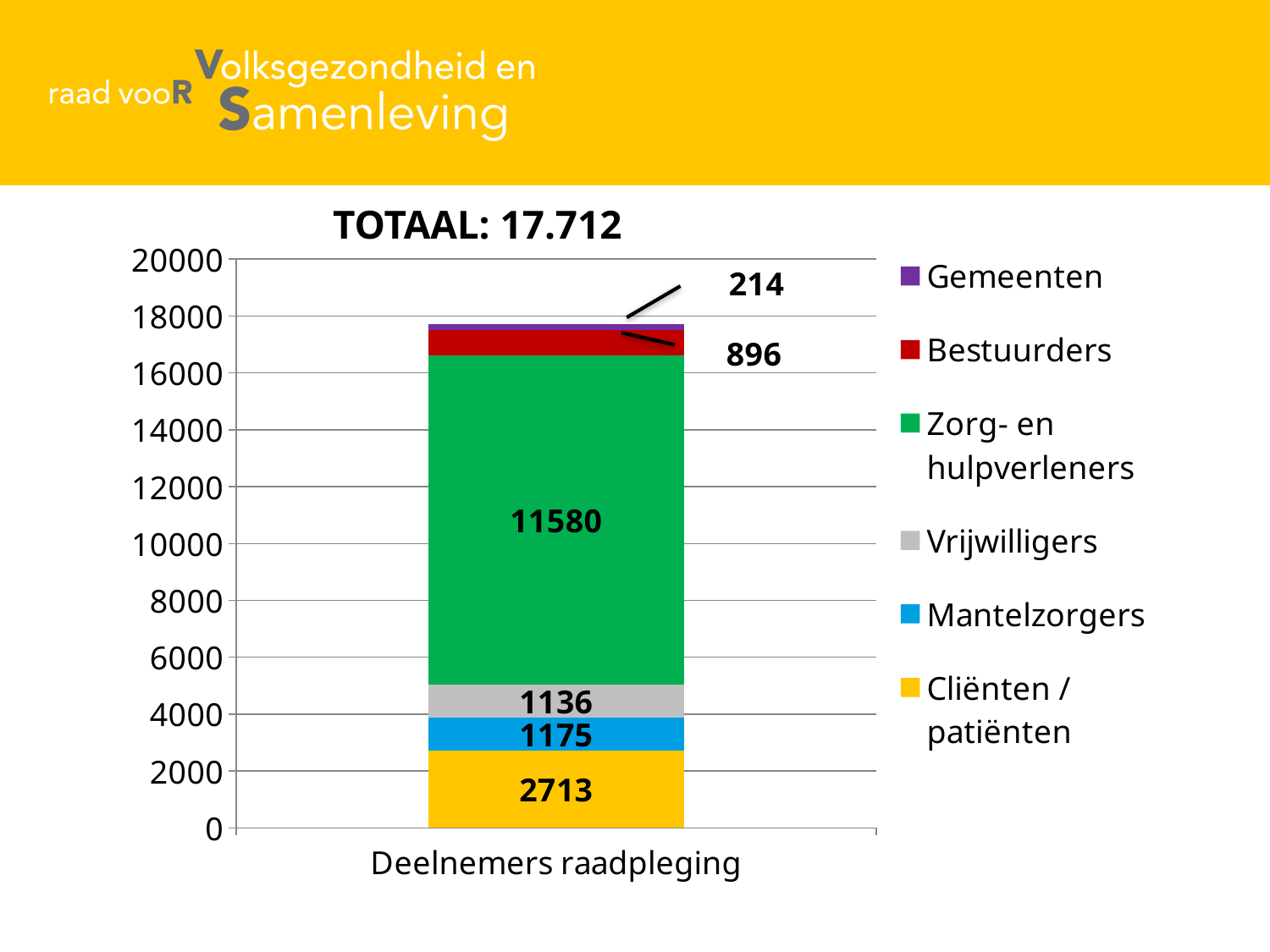
What is the value for Cliënten / patiënten? 2713 What total does the chart title state? 17.712 Which is larger, the value for Mantelzorgers or the value for Vrijwilligers? Mantelzorgers What is the difference between the values for Mantelzorgers and Vrijwilligers? 39 What is the value for Zorg- en hulpverleners in the stacked bar? 11580 What is the difference between the values for Cliënten / patiënten and Bestuurders? 1817 What kind of chart is shown on the slide? Stacked bar chart What is the value for Gemeenten? 214 Which group has the smallest segment in the stacked bar? Gemeenten What is the value for Bestuurders? 896 How many series does the legend list? 6 Which group has the largest segment in the stacked bar? Zorg- en hulpverleners